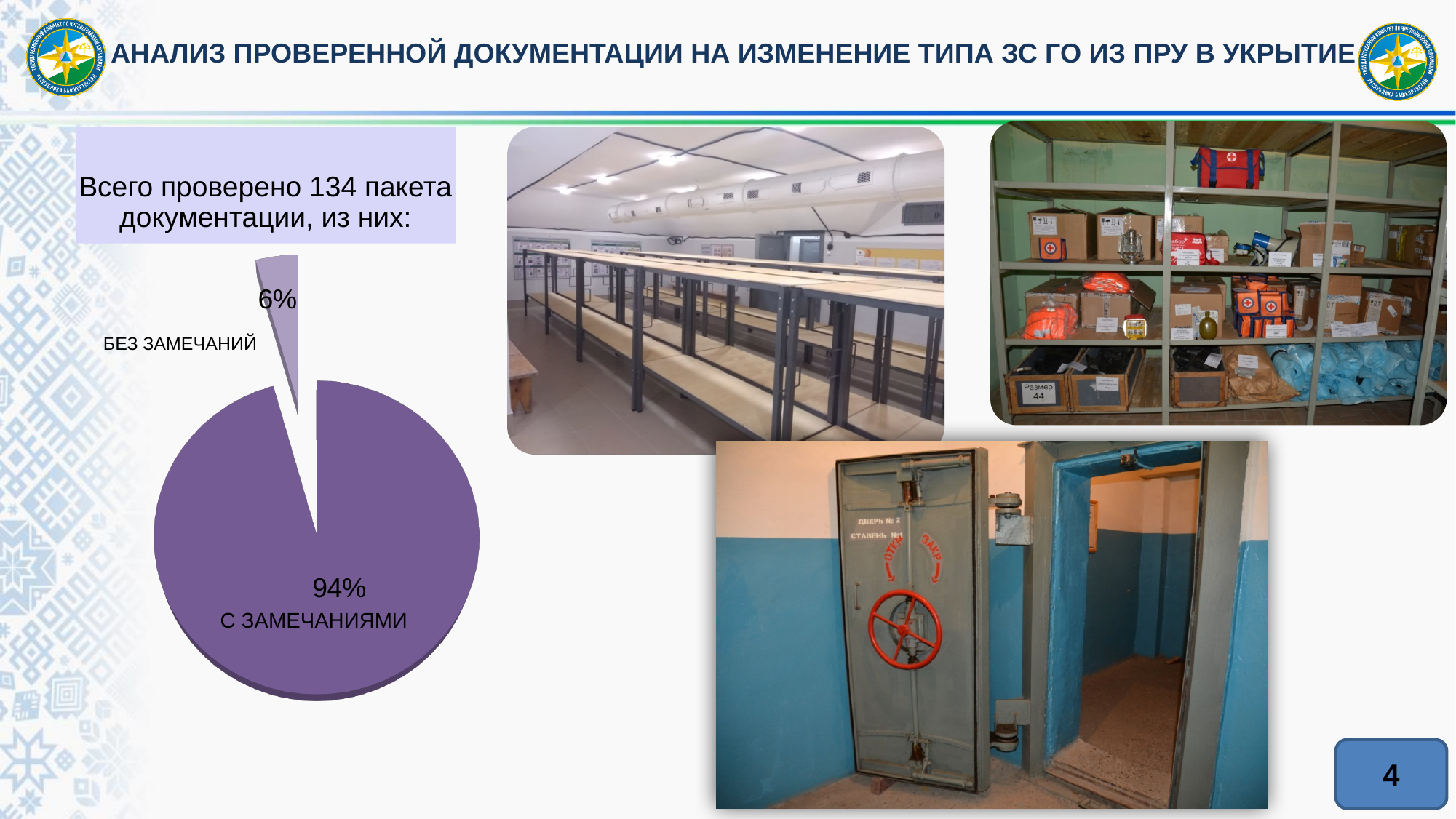
What share of the pie does the slice labelled "БЕЗ ЗАМЕЧАНИЙ" represent? 6% Which slice of the pie chart is pulled out (exploded) from the rest of the pie? БЕЗ ЗАМЕЧАНИЙ Which is larger: the share for "БЕЗ ЗАМЕЧАНИЙ" or the share for "С ЗАМЕЧАНИЯМИ"? С ЗАМЕЧАНИЯМИ What is the difference in percentage points between the "С ЗАМЕЧАНИЯМИ" slice and the "БЕЗ ЗАМЕЧАНИЙ" slice? 88 percentage points What kind of chart is shown on the slide? Pie chart What share of the pie does the slice labelled "С ЗАМЕЧАНИЯМИ" represent? 94% Which slice of the pie chart is the largest? С ЗАМЕЧАНИЯМИ According to the text box above the pie chart, how many documentation packages were checked in total? 134 How many slices does the pie chart have? 2 Which slice of the pie chart is the smallest? БЕЗ ЗАМЕЧАНИЙ